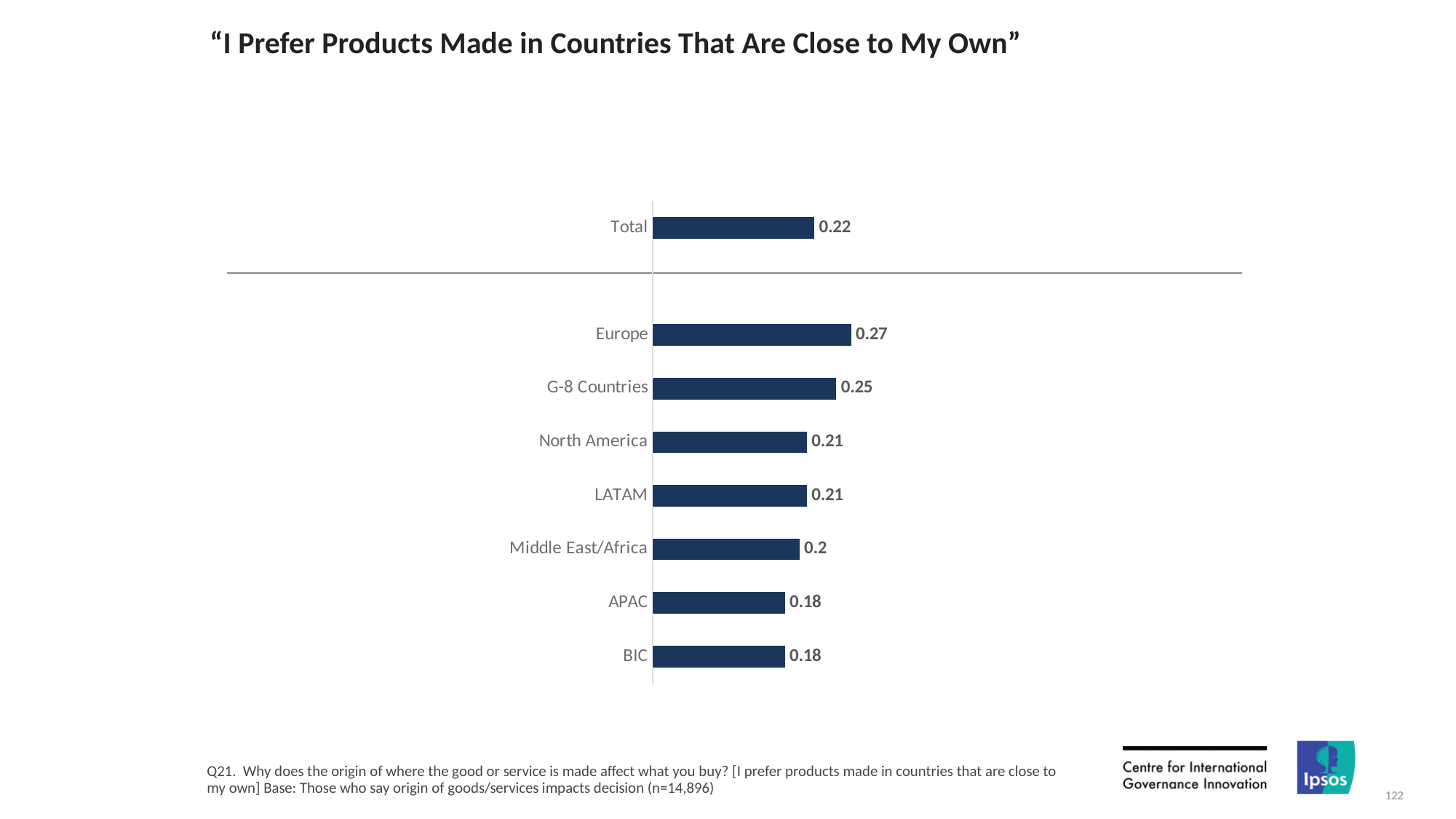
Which is larger, the value for Europe or the value for APAC? Europe What is the value for Total? 0.22 What kind of chart is shown on the slide? Bar chart What is the title of the chart? "I Prefer Products Made in Countries That Are Close to My Own" What is the value for Middle East/Africa? 0.2 What is the difference between the values for G-8 Countries and North America? 0.04 How many bars are shown on the chart, including Total? 8 Which is larger, the value for G-8 Countries or the value for Middle East/Africa? G-8 Countries Which region has the highest value? Europe What is the difference between the values for Europe and BIC? 0.09 What is the value for Europe? 0.27 What is the value for G-8 Countries? 0.25